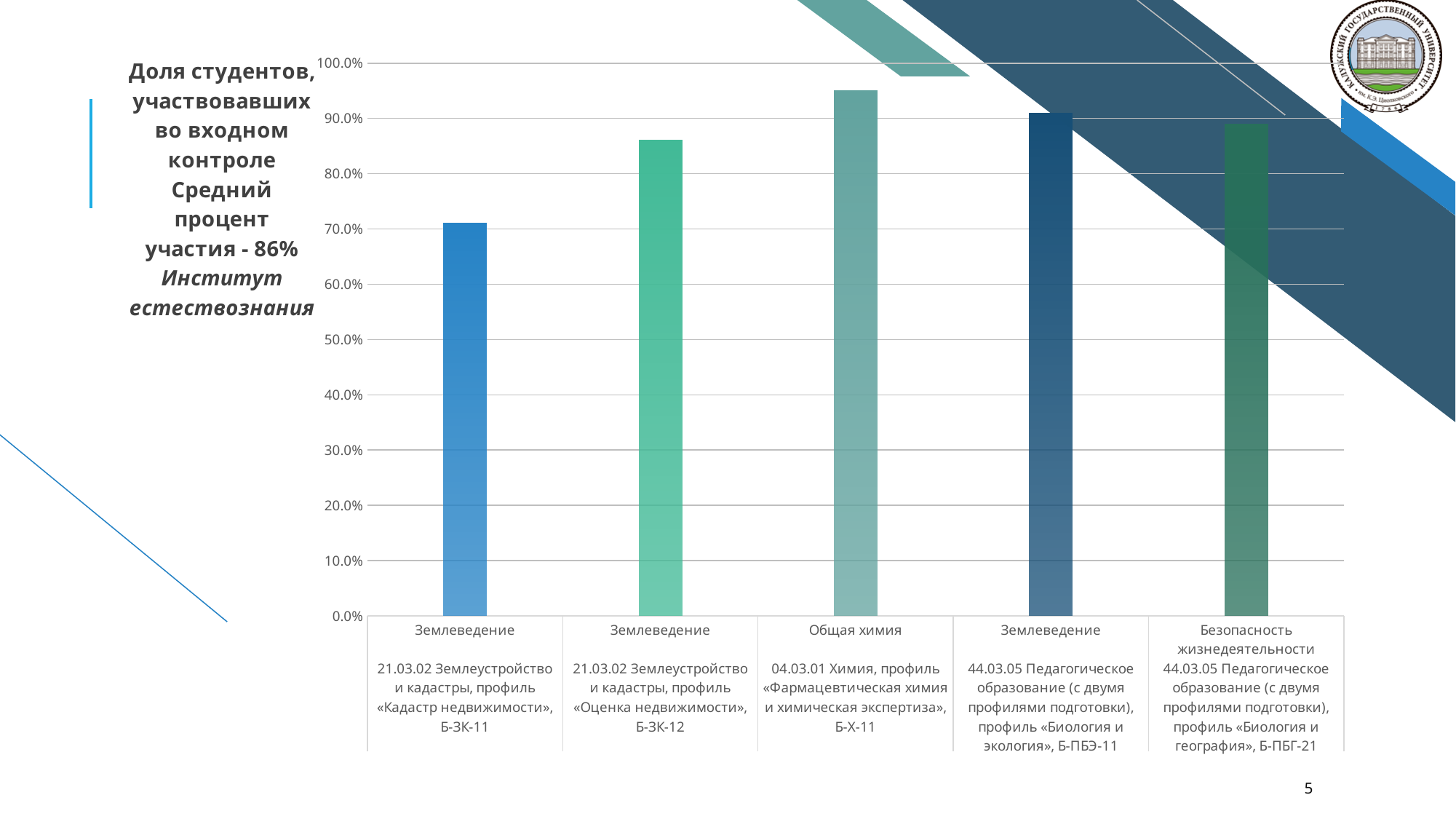
Is the value for Б-ЗК-11 greater or less than 80.0%? less How many bars (groups) are plotted in the chart? 5 Is the value for Б-ЗК-12 greater or less than 80.0%? greater Which is larger: the value for Б-ЗК-12 or the value for Б-ПБЭ-11? Б-ПБЭ-11 Is the value for Б-ПБЭ-11 greater or less than 80.0%? greater Which is larger: the value for Б-ЗК-11 or the value for Б-Х-11? Б-Х-11 According to the slide text, what is the average participation percentage for the Институт естествознания? 86% Which group has the highest share of students who took part in the entrance control? Общая химия, Б-Х-11 What kind of chart is shown on the slide? bar chart Which group has the lowest share of students who took part in the entrance control? Землеведение, Б-ЗК-11